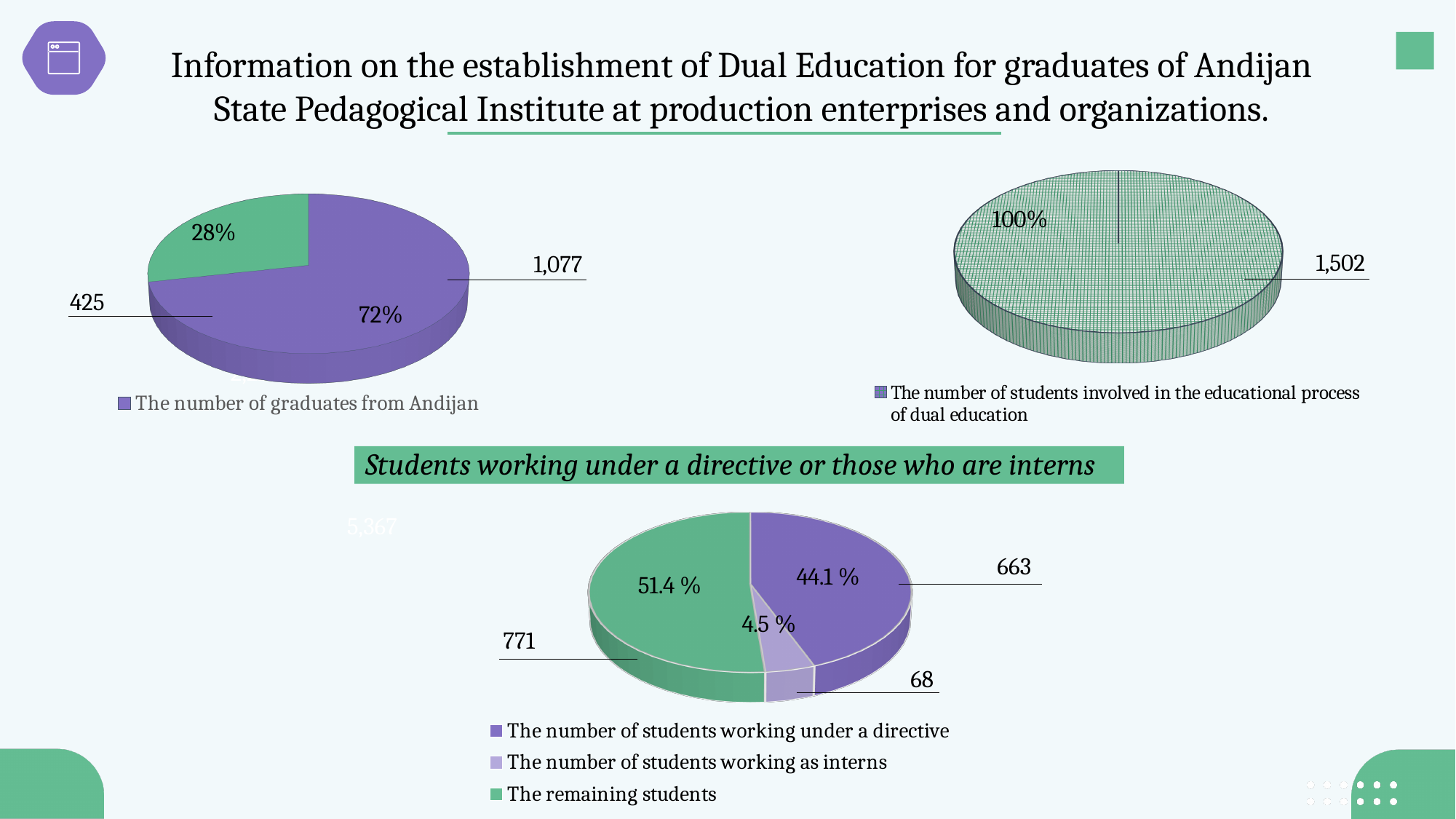
In the bottom chart titled 'Students working under a directive or those who are interns', what is the value for the number of students working as interns? 68 In the bottom chart titled 'Students working under a directive or those who are interns', what is the difference between the remaining students and the students working under a directive? 108 In the bottom chart titled 'Students working under a directive or those who are interns', what percentage share is shown for students working as interns? 4.5 % In the top-left pie chart, what value is shown for the green slice labelled 28%? 425 In the bottom chart titled 'Students working under a directive or those who are interns', what is the value for the number of students working under a directive? 663 In the bottom chart titled 'Students working under a directive or those who are interns', what percentage share is shown for the remaining students? 51.4 % In the bottom chart titled 'Students working under a directive or those who are interns', what is the value for the remaining students? 771 In the top-left pie chart, what value is shown for the purple slice labelled 72%? 1,077 In the bottom chart titled 'Students working under a directive or those who are interns', which category has the smallest slice? The number of students working as interns In the top-right pie chart, what value is shown for the slice labelled 100%? 1,502 How many entries does the legend of the bottom chart titled 'Students working under a directive or those who are interns' list? 3 In the bottom chart titled 'Students working under a directive or those who are interns', which category has the largest slice? The remaining students